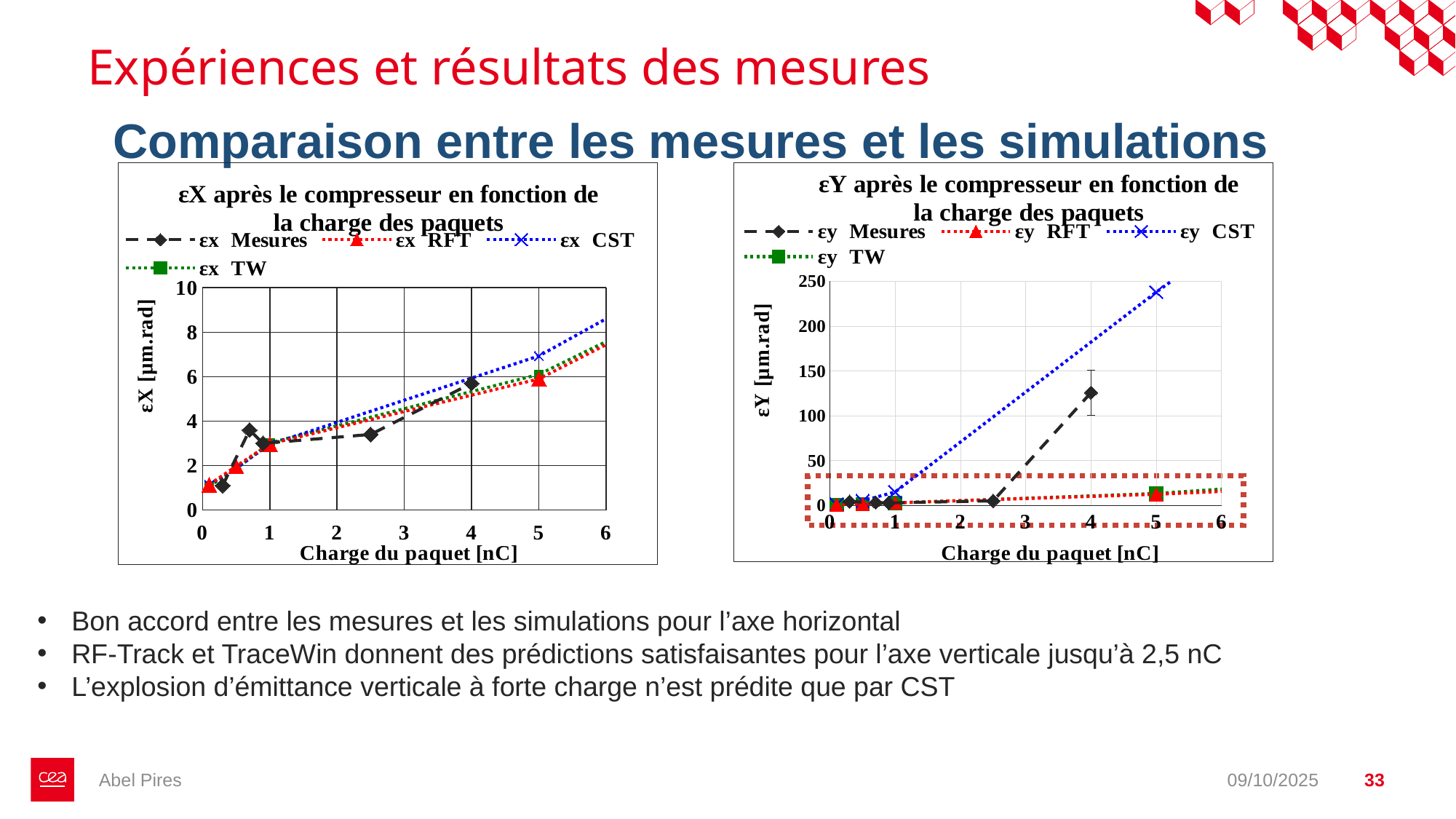
How many series does the legend of the left chart (εX) list? 4 In the right chart (εY), does the εy CST series rise or fall as the charge increases? rise How many series does the legend of the right chart (εY) list? 4 In the right chart (εY), which series reaches the highest value? εy CST In the left chart (εX), is the value of εx CST at 5 nC greater or less than 6? greater In the right chart (εY), at 5 nC, which is larger: εy CST or εy TW? εy CST In the left chart (εX), is the value of εx Mesures at 4 nC greater or less than 4? greater What kind of chart is the left chart, 'εX après le compresseur en fonction de la charge des paquets'? line chart In the right chart (εY), is the value of εy CST at 5 nC greater or less than 200? greater What is the x-axis label of the left chart (εX)? Charge du paquet [nC]